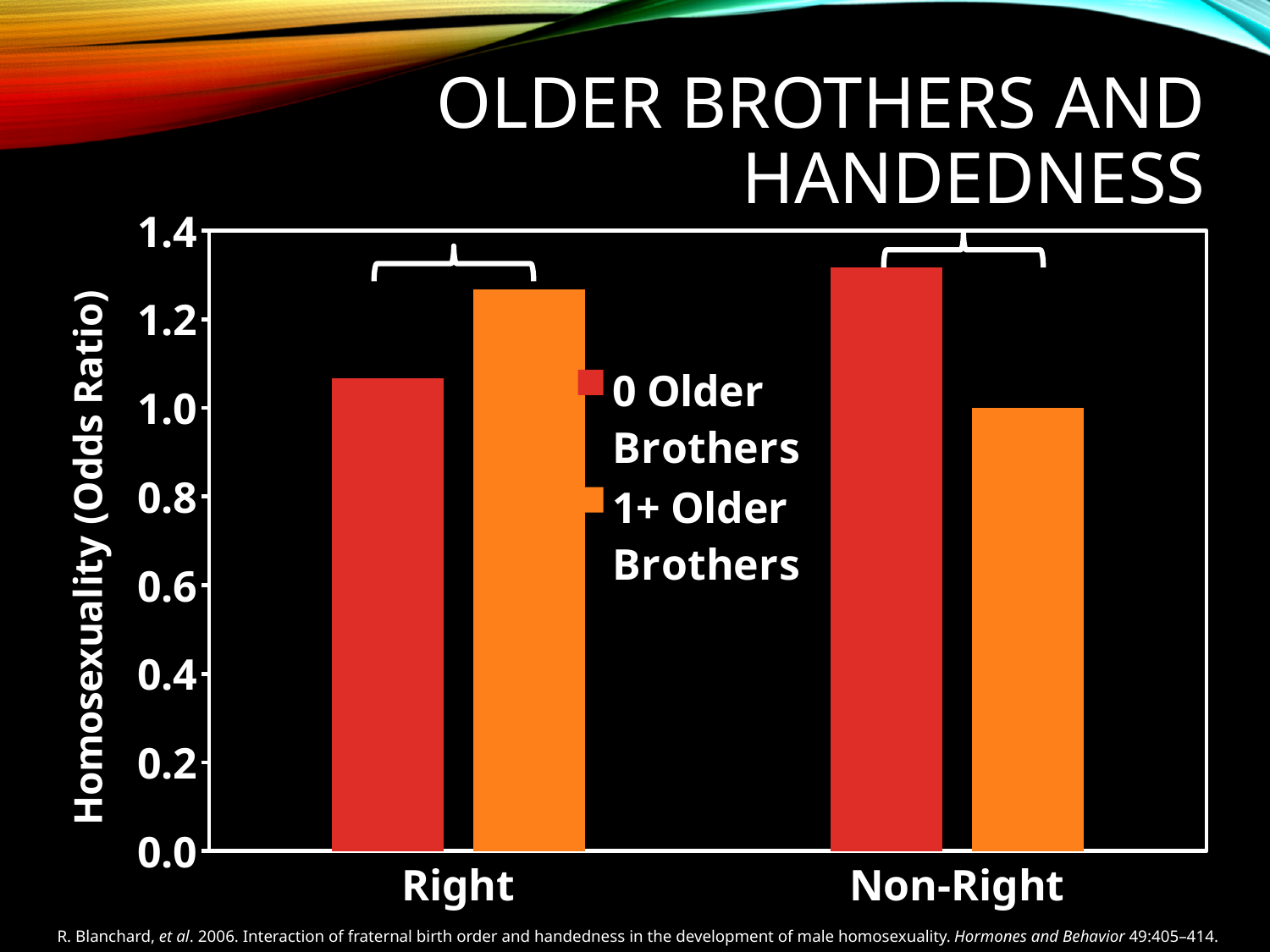
In the Non-Right category, which series has the larger value, 0 Older Brothers or 1+ Older Brothers? 0 Older Brothers Which bar is the tallest in the chart? 0 Older Brothers, Non-Right Is the value for 0 Older Brothers in the Non-Right category greater or less than 1.2? greater What kind of chart is shown on the slide? bar chart Which series is shown in orange in the legend? 1+ Older Brothers Is the value for 0 Older Brothers in the Right category greater or less than 1.2? less In the Right category, which series has the larger value, 0 Older Brothers or 1+ Older Brothers? 1+ Older Brothers Is the value for 1+ Older Brothers in the Right category greater or less than 1.2? greater How many series does the legend list? 2 How many handedness categories are shown on the x axis? 2 What is the label of the y axis? Homosexuality (Odds Ratio)